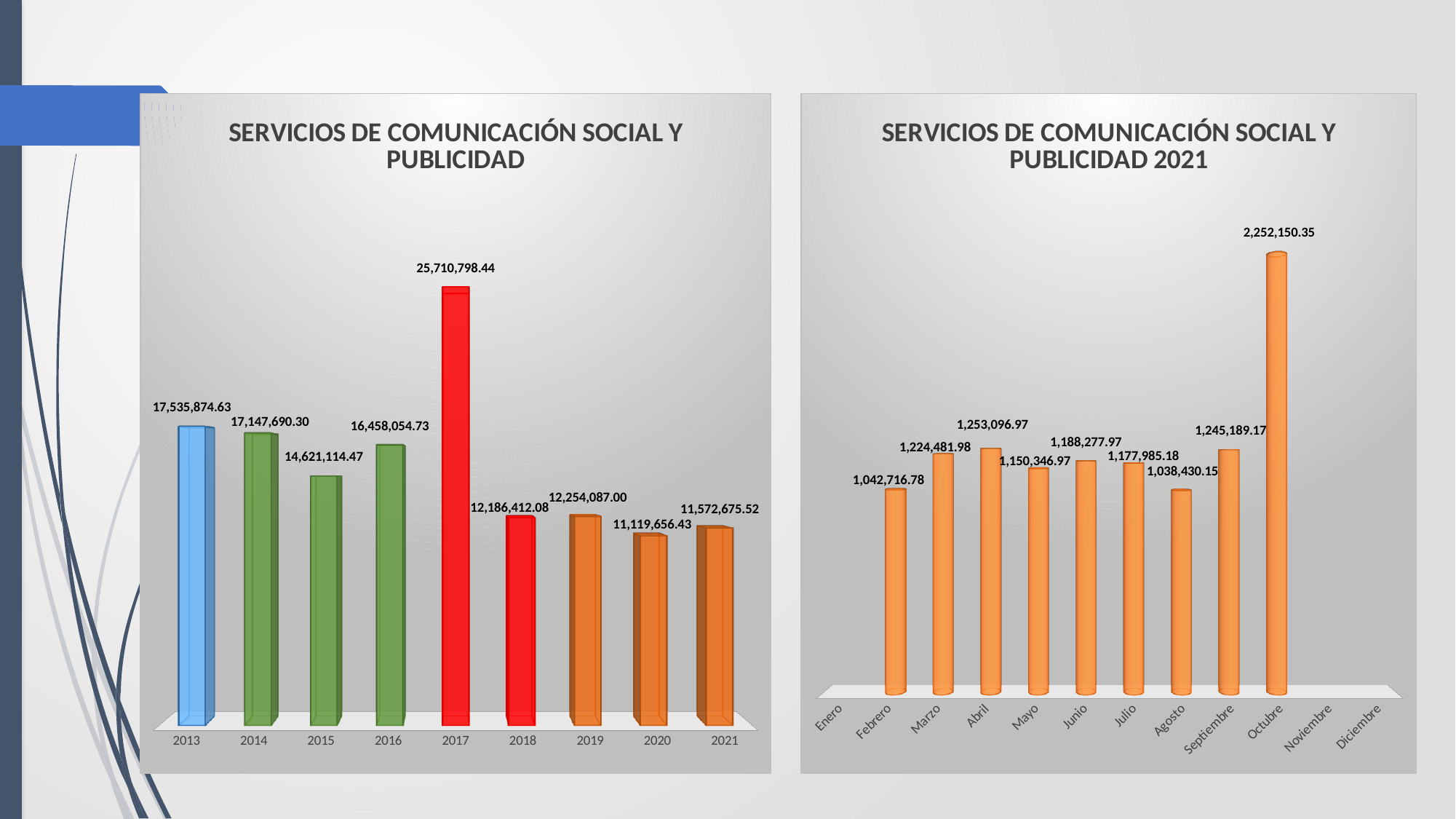
In the left chart, which year has the lowest value? 2020 In the left chart, which is larger, the value for 2018 or the value for 2019? 2019 In the right chart, which month has the lowest value? Agosto In the left chart, what is the value for 2021? 11,572,675.52 In the right chart, how many months are listed on the x axis? 12 In the left chart, which year has the highest value? 2017 In the left chart (SERVICIOS DE COMUNICACIÓN SOCIAL Y PUBLICIDAD), what is the value for 2017? 25,710,798.44 In the right chart, what is the difference between the values for Octubre and Septiembre? 1,006,961.18 What kind of chart is the right chart? Bar chart In the left chart, how many years are shown on the x axis? 9 In the right chart (SERVICIOS DE COMUNICACIÓN SOCIAL Y PUBLICIDAD 2021), what is the value for Octubre? 2,252,150.35 In the left chart, what is the difference between the values for 2013 and 2014? 388,184.33